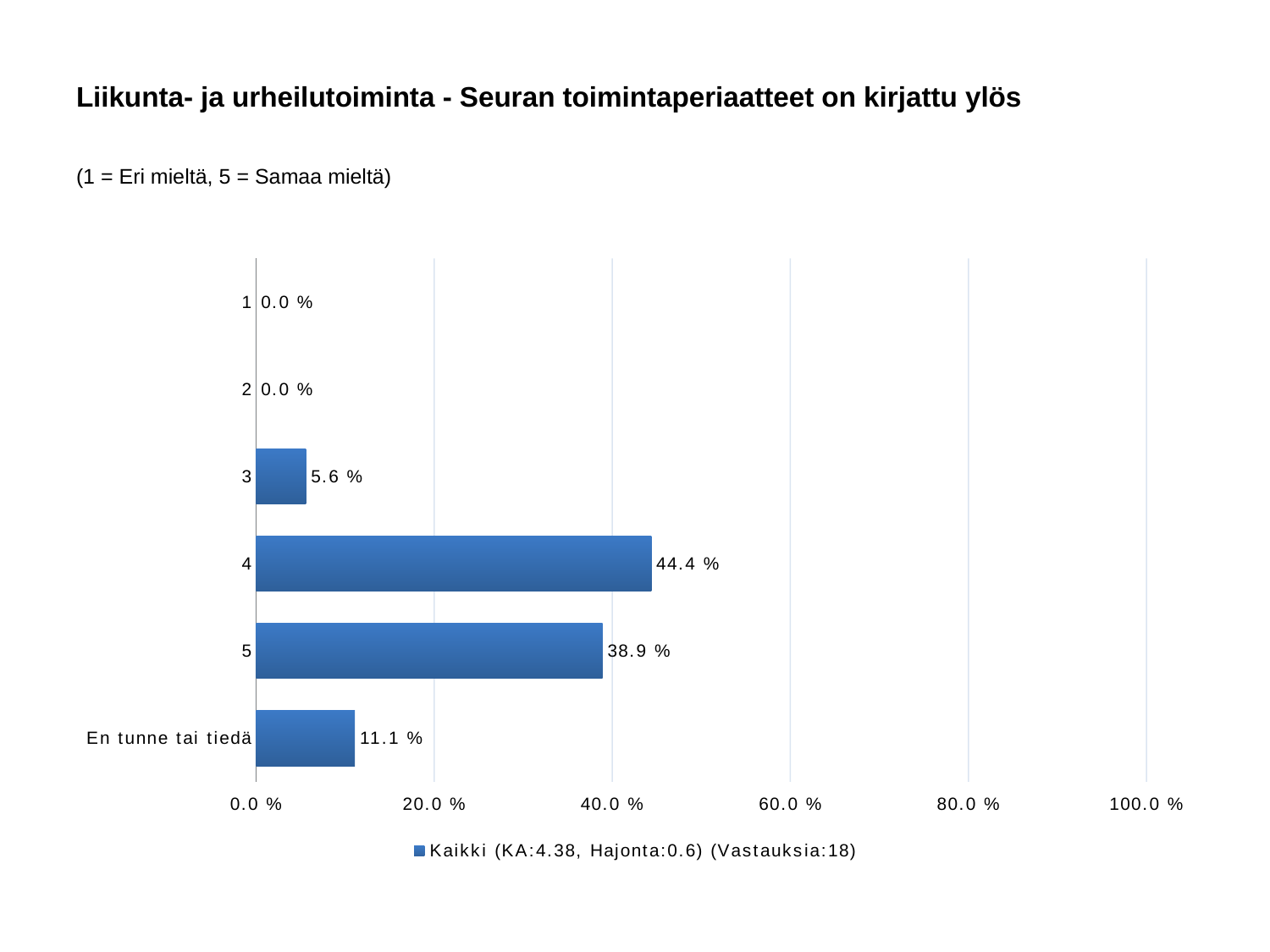
How many series does the legend list? 1 Is the value for category 4 greater or less than 40.0 %? greater What is the difference between the values for category 4 and category 5? 5.5 % What kind of chart is shown on the slide? bar chart What is the value for 'En tunne tai tiedä'? 11.1 % Which category has the highest value? 4 What is the value for category 3? 5.6 % What is the legend entry for the series? Kaikki (KA:4.38, Hajonta:0.6) (Vastauksia:18) How many categories are shown on the chart? 6 Which is larger, the value for category 5 or the value for 'En tunne tai tiedä'? 5 What is the value for category 4? 44.4 % What is the value for category 5? 38.9 %